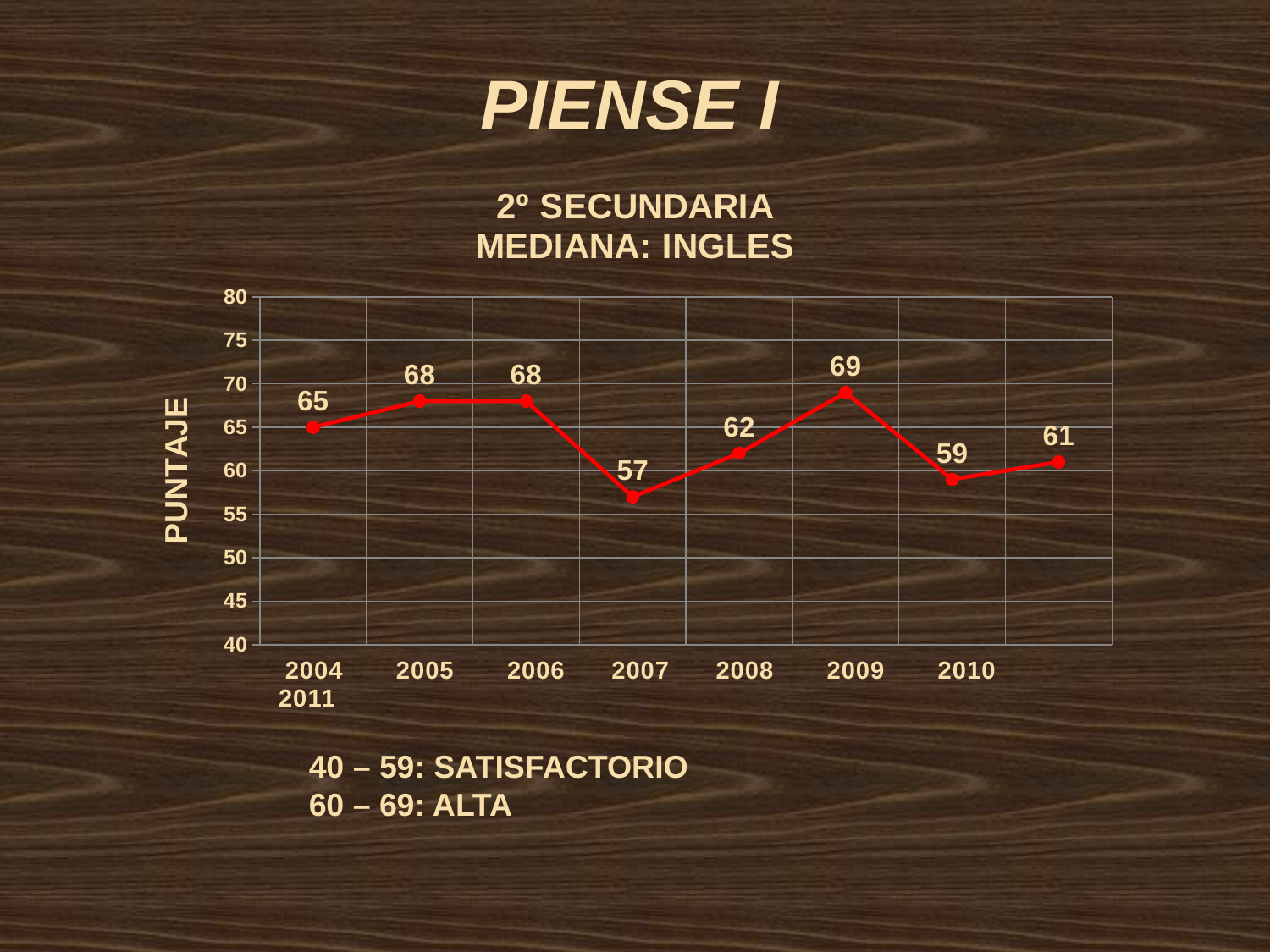
How many data points are plotted on the line? 8 Which year has the lowest value on the chart? 2007 What type of chart is shown on the slide? line chart Does the value rise or fall from 2009 to 2010? fall What is the value plotted for 2010? 59 What is the difference between the values for 2006 and 2007? 11 Which year has the highest value on the chart? 2009 What is the label on the vertical axis of the chart? PUNTAJE What is the median English score (PUNTAJE) for 2004? 65 What is the value plotted for 2007? 57 Which is larger, the value for 2008 or the value for 2010? 2008 What is the value plotted for 2009? 69